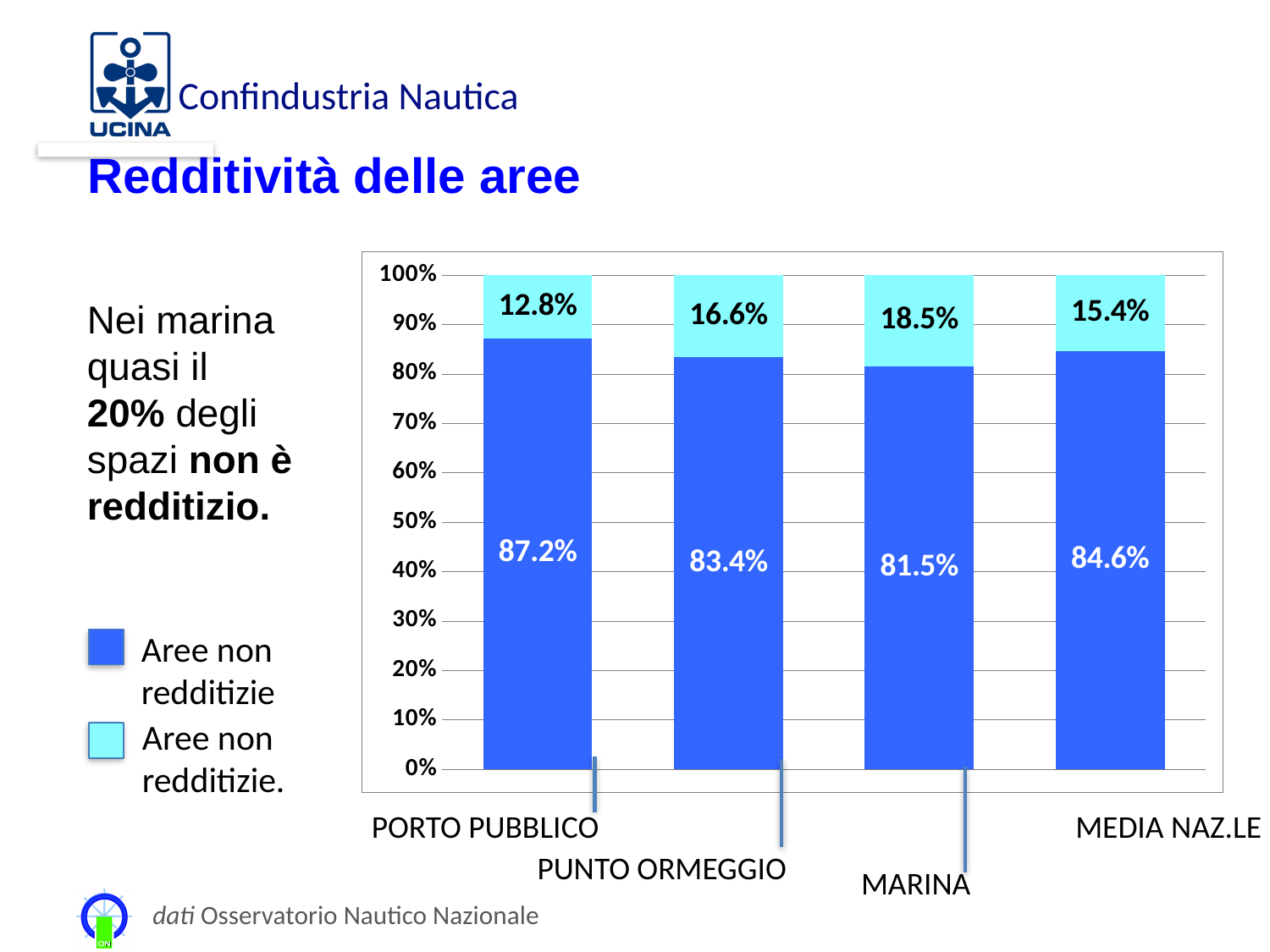
What is the value of the dark blue segment for PORTO PUBBLICO? 87.2% What is the value of the light blue segment for MEDIA NAZ.LE? 15.4% How many categories are shown on the x axis of the chart? 4 Which category has the largest light blue segment? MARINA What is the difference between the light blue segment for MARINA and the light blue segment for PORTO PUBBLICO? 5.7% Which has the larger dark blue segment, PUNTO ORMEGGIO or MEDIA NAZ.LE? MEDIA NAZ.LE Which category has the largest dark blue segment? PORTO PUBBLICO What is the value of the dark blue segment for PUNTO ORMEGGIO? 83.4% What kind of chart is shown on the slide? Stacked bar chart What is the total of the stacked bar for PORTO PUBBLICO? 100% Which category has the smallest light blue segment? PORTO PUBBLICO What is the value of the light blue segment for MARINA? 18.5%